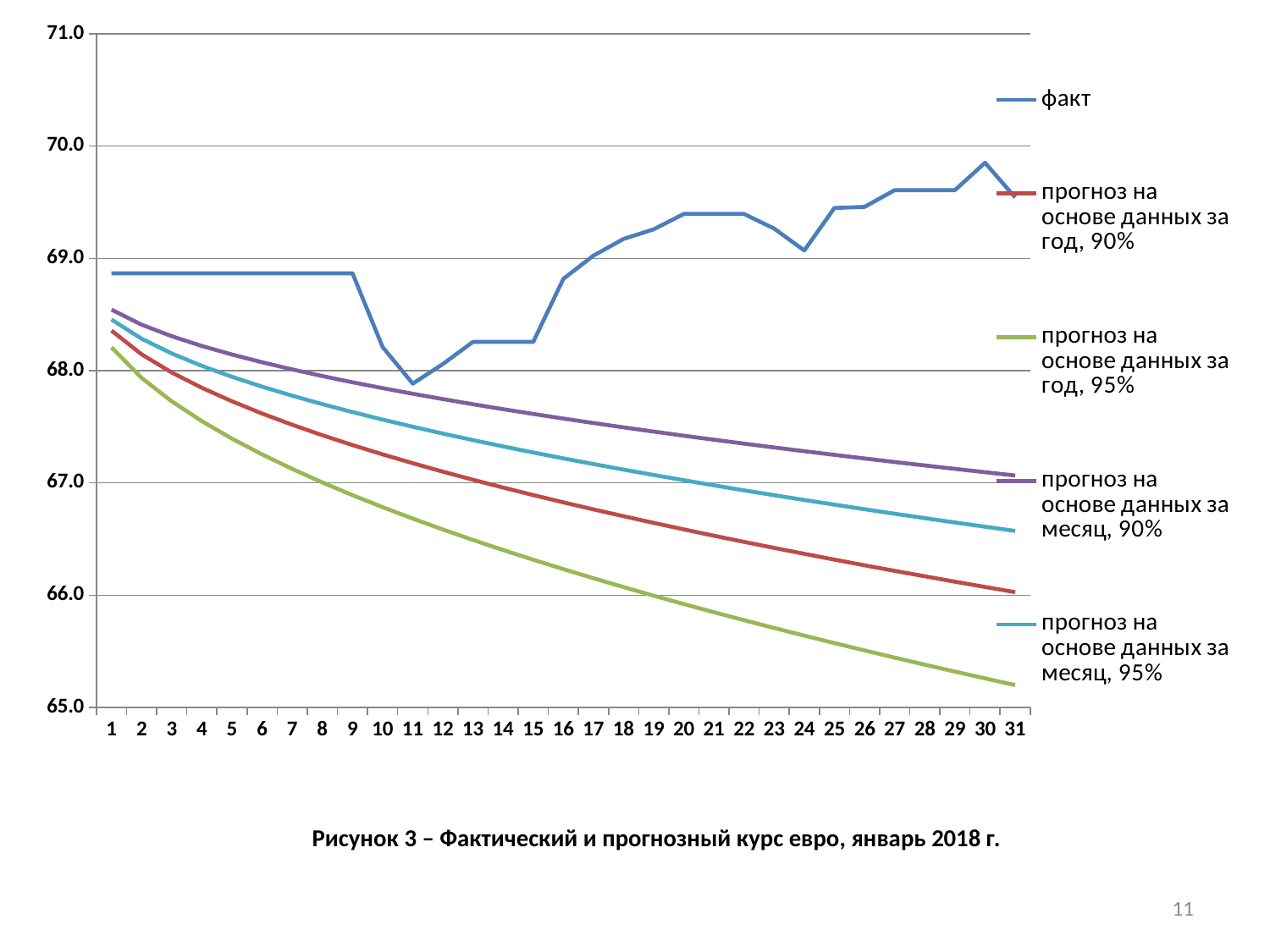
What kind of chart is shown on the slide? line chart How many series does the legend list? 5 Is the value of the прогноз на основе данных за год, 95% series at point 31 greater or less than 67.0? less Which series has the lowest value at point 31? прогноз на основе данных за год, 95% Is the value of the факт series at point 30 greater or less than 69.0? greater What is the caption of the figure shown on the slide? Рисунок 3 – Фактический и прогнозный курс евро, январь 2018 г. How many points are on the x axis of the chart? 31 Is the value of the прогноз на основе данных за месяц, 95% series at point 31 greater or less than 66.0? greater Do the values of the прогноз на основе данных за месяц, 95% series rise or fall from point 1 to point 31? fall Which series has the highest value at point 31? факт Among the forecast series, which one is highest at point 31? прогноз на основе данных за месяц, 90%